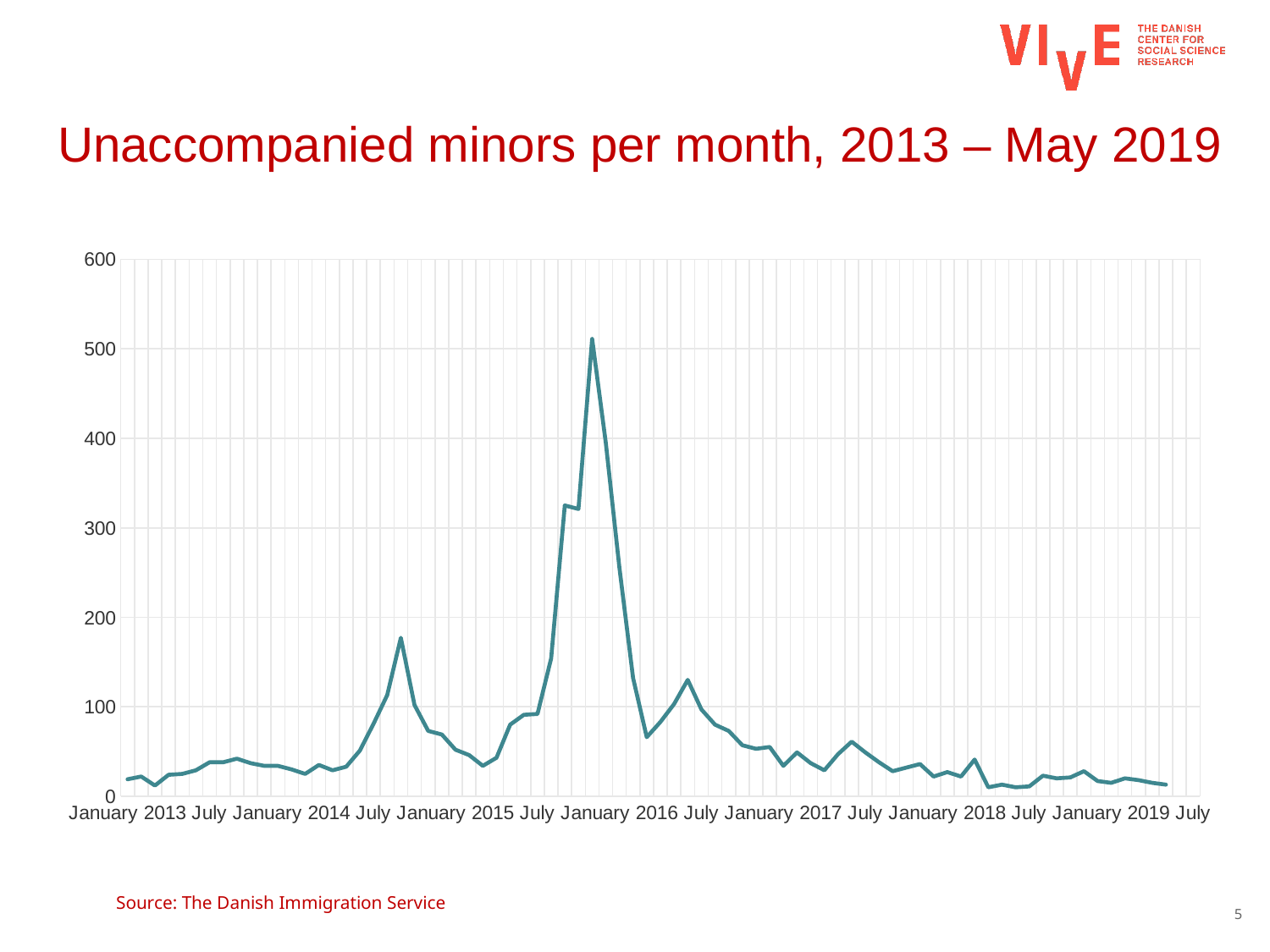
Do the values rise or fall between the late 2015 peak and July 2016? fall In which period does the line reach its highest point? late 2015 What source is cited for the chart's data? The Danish Immigration Service What is the title of the chart? Unaccompanied minors per month, 2013 – May 2019 Are the values during 2018 greater or less than 100? less What is the highest value shown on the y axis? 600 Which is larger, the peak in late 2014 or the peak in late 2015? the peak in late 2015 Is the value for January 2013 greater or less than 100? less Is the highest value on the chart greater or less than 400? greater What kind of chart is shown on the slide? line chart